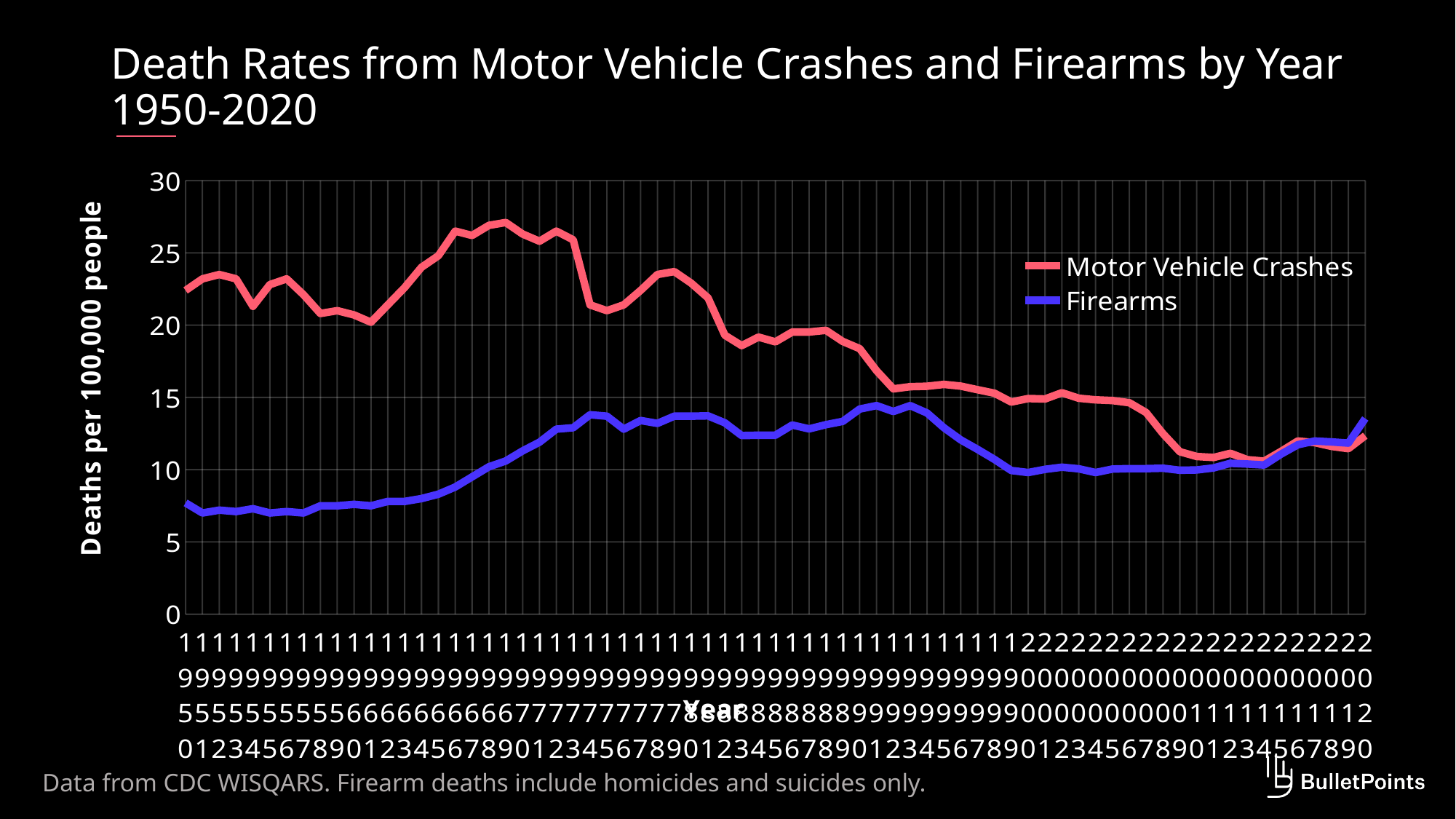
Which series reaches the highest value anywhere on the chart? Motor Vehicle Crashes Is the Motor Vehicle Crashes value for 2010 greater or less than 15? less Is the Firearms value for 1950 greater or less than 10? less Is the Motor Vehicle Crashes value for 1970 greater or less than 25? greater Does the Motor Vehicle Crashes line generally rise or fall from 1970 to 2010? fall In 1980, which series has the higher death rate, Motor Vehicle Crashes or Firearms? Motor Vehicle Crashes What is the label on the vertical axis? Deaths per 100,000 people How many series does the legend list? 2 What are the two series named in the legend? Motor Vehicle Crashes and Firearms What kind of chart is shown on the slide? Line chart